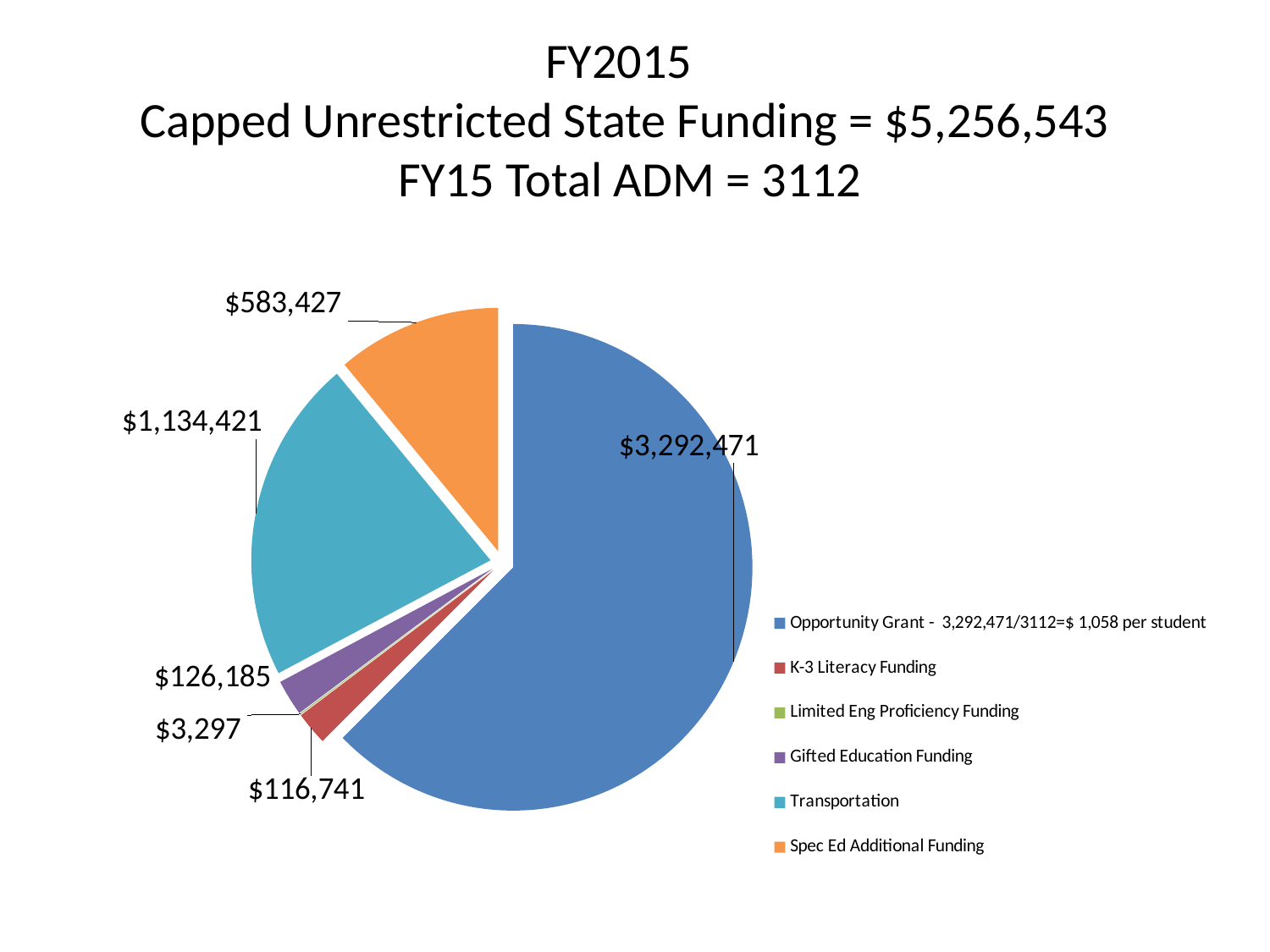
What is the value of the Limited Eng Proficiency Funding slice? $3,297 What is the value of the Transportation slice? $1,134,421 Which category has the smallest slice of the pie? Limited Eng Proficiency Funding What is the difference between the Transportation value and the Spec Ed Additional Funding value? $550,994 Which category has the largest slice of the pie? Opportunity Grant Which is larger, Gifted Education Funding or K-3 Literacy Funding? Gifted Education Funding What is the value of the Spec Ed Additional Funding slice? $583,427 What colour is the Transportation slice? teal How many slices does the pie chart have? 6 What type of chart is shown on the slide? pie chart What is the value of the K-3 Literacy Funding slice? $116,741 What is the difference between the Gifted Education Funding value and the K-3 Literacy Funding value? $9,444